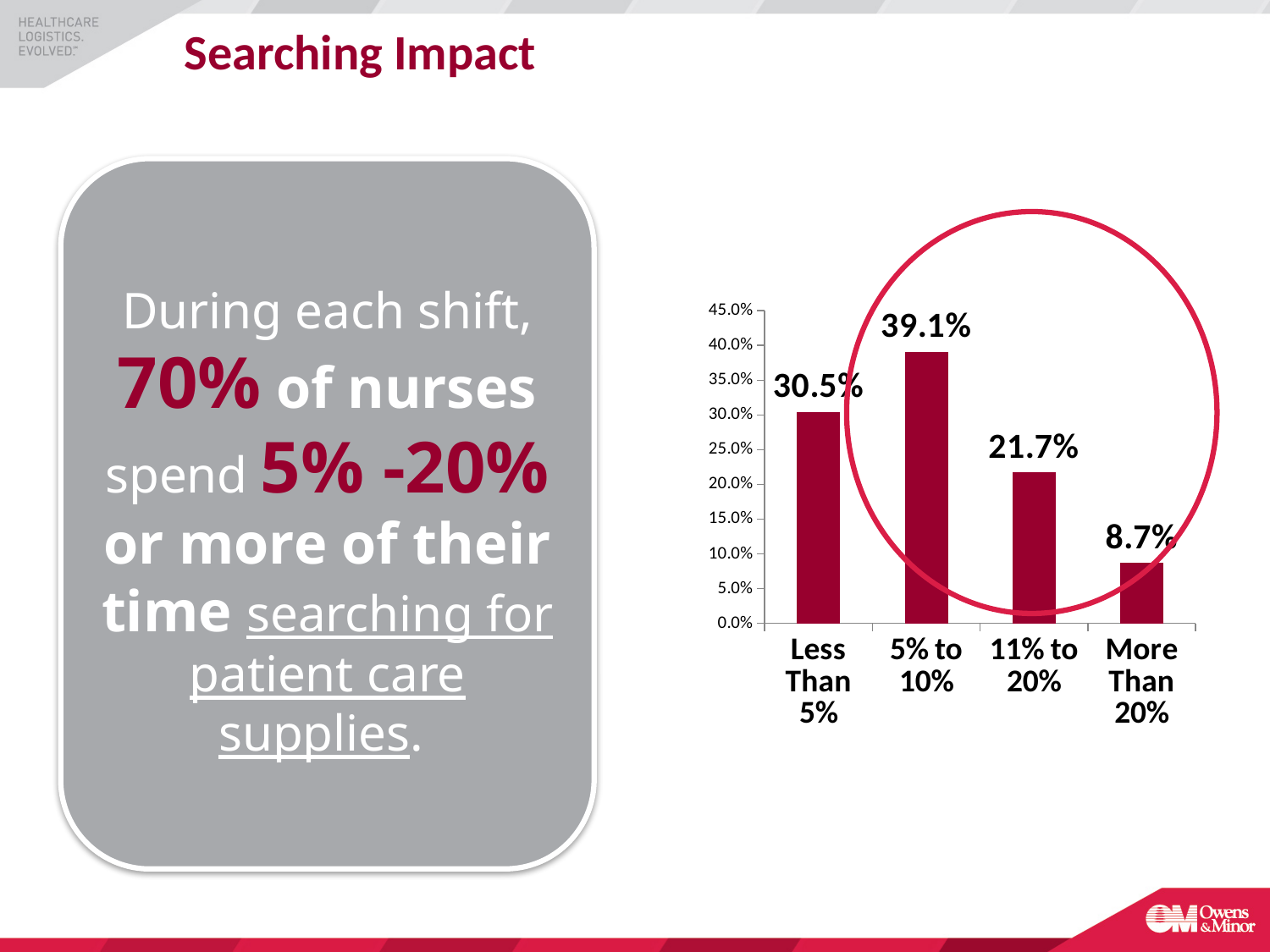
What is the value for the '11% to 20%' category? 21.7% What is the difference between the values for '5% to 10%' and 'Less Than 5%'? 8.6% How many categories are shown on the x axis of the chart? 4 What is the value for the 'More Than 20%' category? 8.7% Which category has the lowest value? More Than 20% What is the value for the 'Less Than 5%' category? 30.5% What is the value for the '5% to 10%' category? 39.1% What is the combined value of the '5% to 10%' and '11% to 20%' categories? 60.8% Is the value for 'Less Than 5%' greater or less than 25.0%? greater Which is larger, the value for '11% to 20%' or the value for 'More Than 20%'? 11% to 20% Which category has the highest value? 5% to 10% What kind of chart is shown on the slide? Bar chart